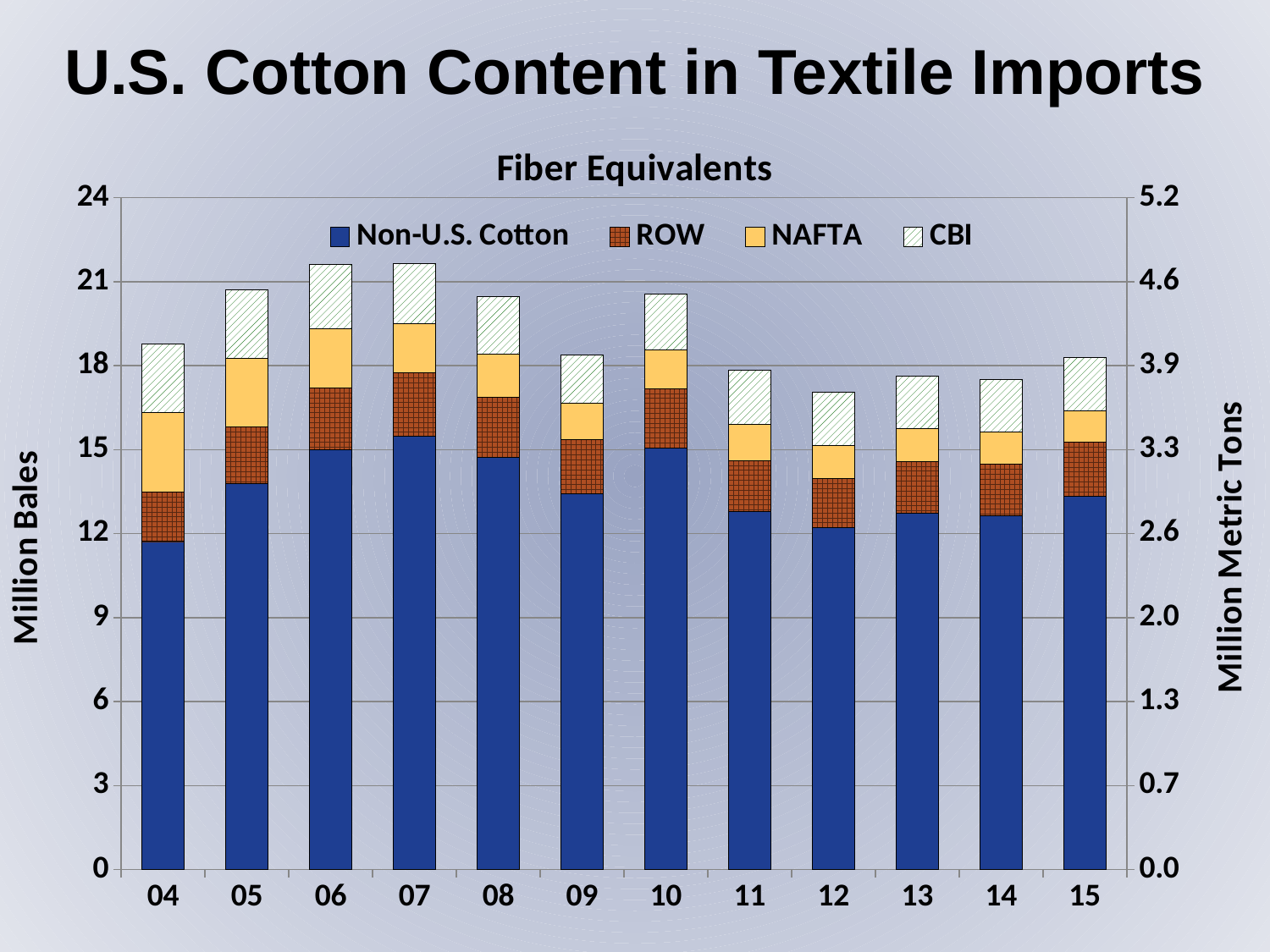
Which year has the lowest Non-U.S. Cotton value? 04 Is the total stacked bar for 12 greater or less than 18 million bales? less What is the label of the left vertical axis? Million Bales Is the Non-U.S. Cotton value for 07 greater or less than 15 million bales? greater How many series does the legend list? 4 What kind of chart is shown on the slide? Stacked bar chart Do the total stacked bars rise or fall from 10 to 12? fall Is the Non-U.S. Cotton value for 04 greater or less than 12 million bales? less How many years are shown along the x axis? 12 Which year has the taller total stacked bar, 04 or 05? 05 Which year has the taller total stacked bar, 10 or 11? 10